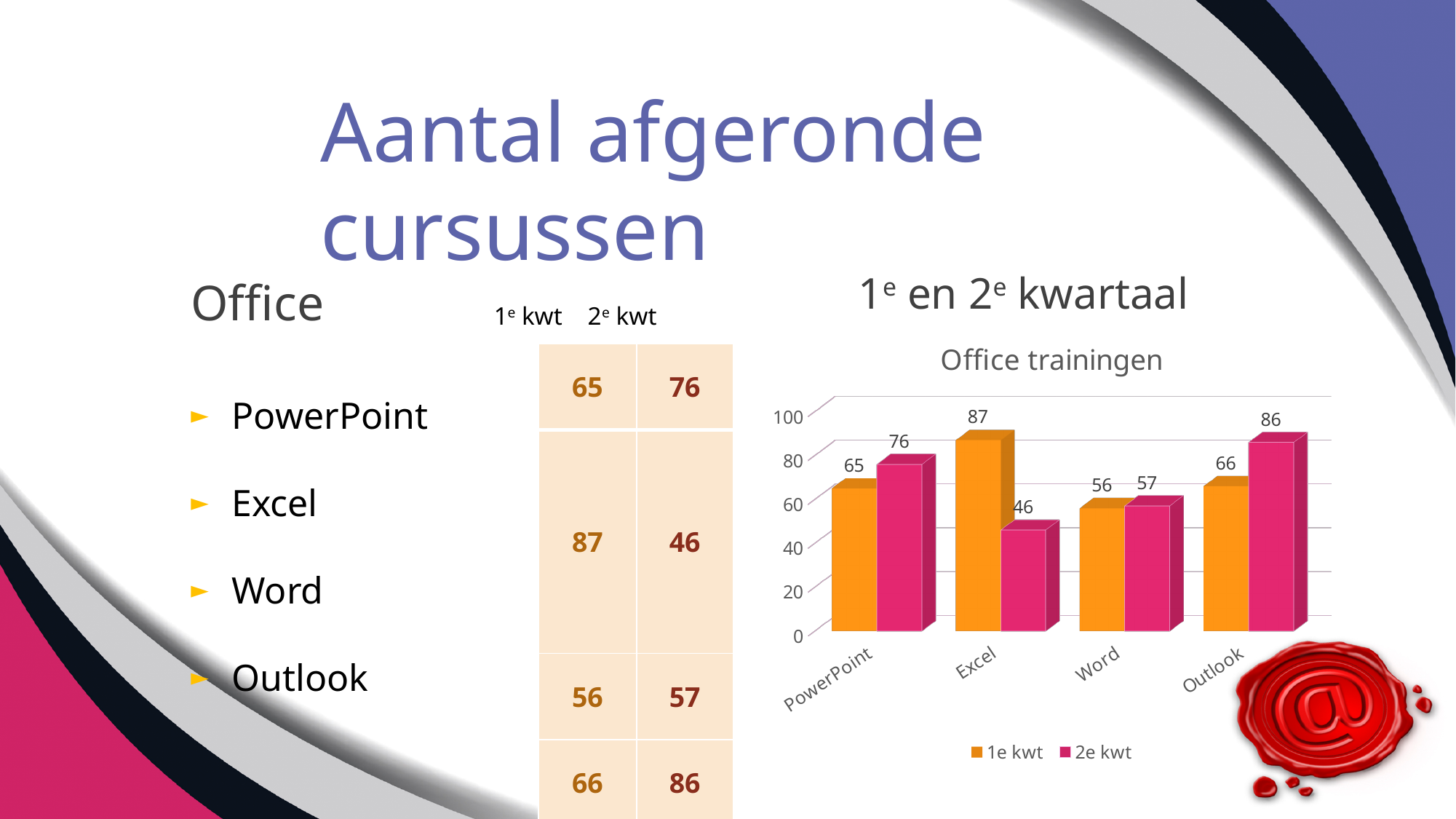
What is the value for Outlook in the 2e kwt series? 86 Which category has the lowest value in the 2e kwt series? Excel What is the value for Excel in the 1e kwt series? 87 What is the value for Word in the 1e kwt series? 56 Which is larger for PowerPoint: the 1e kwt value or the 2e kwt value? 2e kwt What is the title of the chart? Office trainingen What is the difference between the 1e kwt and 2e kwt values for Excel? 41 What kind of chart is shown on the slide? bar chart How many categories are shown on the x axis of the chart? 4 How many series does the chart legend list? 2 Which category has the highest value in the 1e kwt series? Excel Is the value for Outlook in the 2e kwt series greater or less than 80? greater